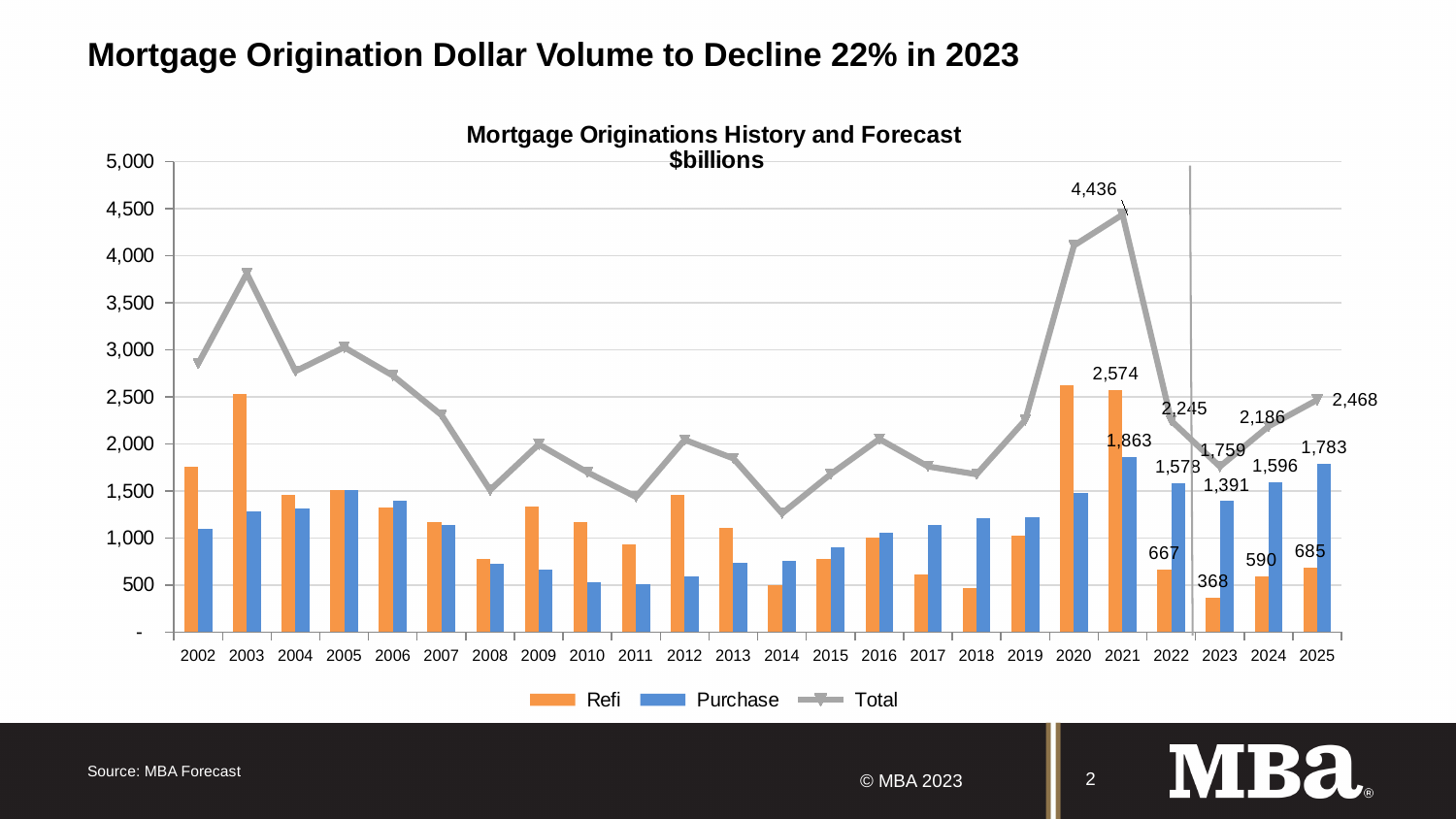
What is the difference between the Purchase and Refi values in 2024? 1,006 How many years are shown on the x axis? 24 What is the Refi value for 2023? 368 Does the Total line rise or fall from 2022 to 2023? fall Which is larger in 2021, Refi or Purchase? Refi What is the Total value for 2023? 1,759 Which year has the lowest Refi value? 2023 What is the Refi value for 2022? 667 Is the Total value for 2003 greater or less than 3,500? greater What is the Purchase value for 2025? 1,783 In which year does the Total line reach its highest value? 2021 How many series does the legend list? 3